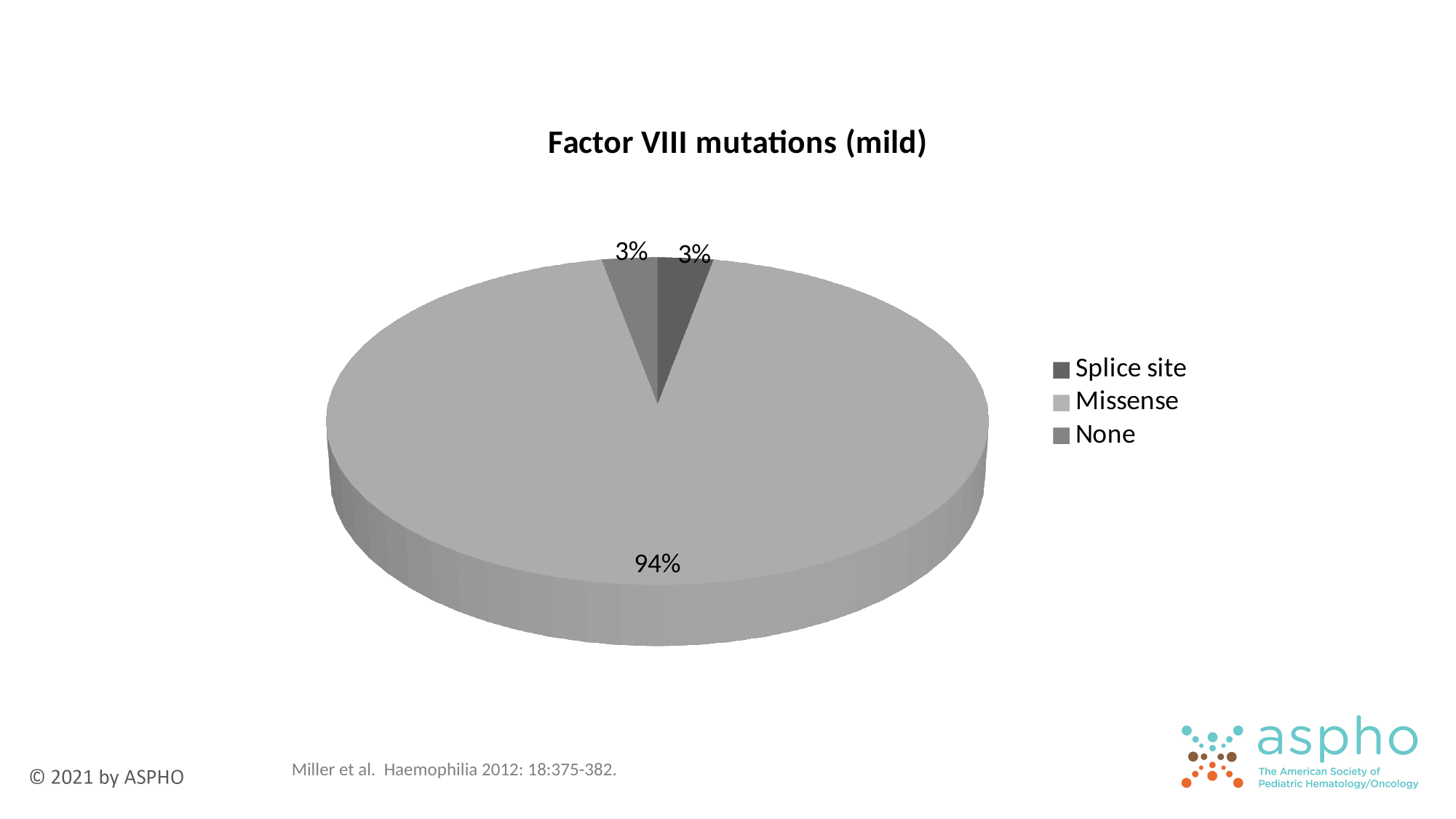
Which category has the largest slice of the pie? Missense How many entries does the legend list? 3 What share of the pie do Splice site and None make up together? 6% What is the title of the chart? Factor VIII mutations (mild) How many categories are shown in the pie chart? 3 What percentage of the pie does Missense account for? 94% What kind of chart is shown on the slide? Pie chart What is the difference in percentage points between Missense and Splice site? 91 What percentage is shown for Splice site? 3% What percentage is shown for the None category? 3% Which legend entry is shown with the darkest colour? Splice site Which is larger, the Missense slice or the None slice? Missense